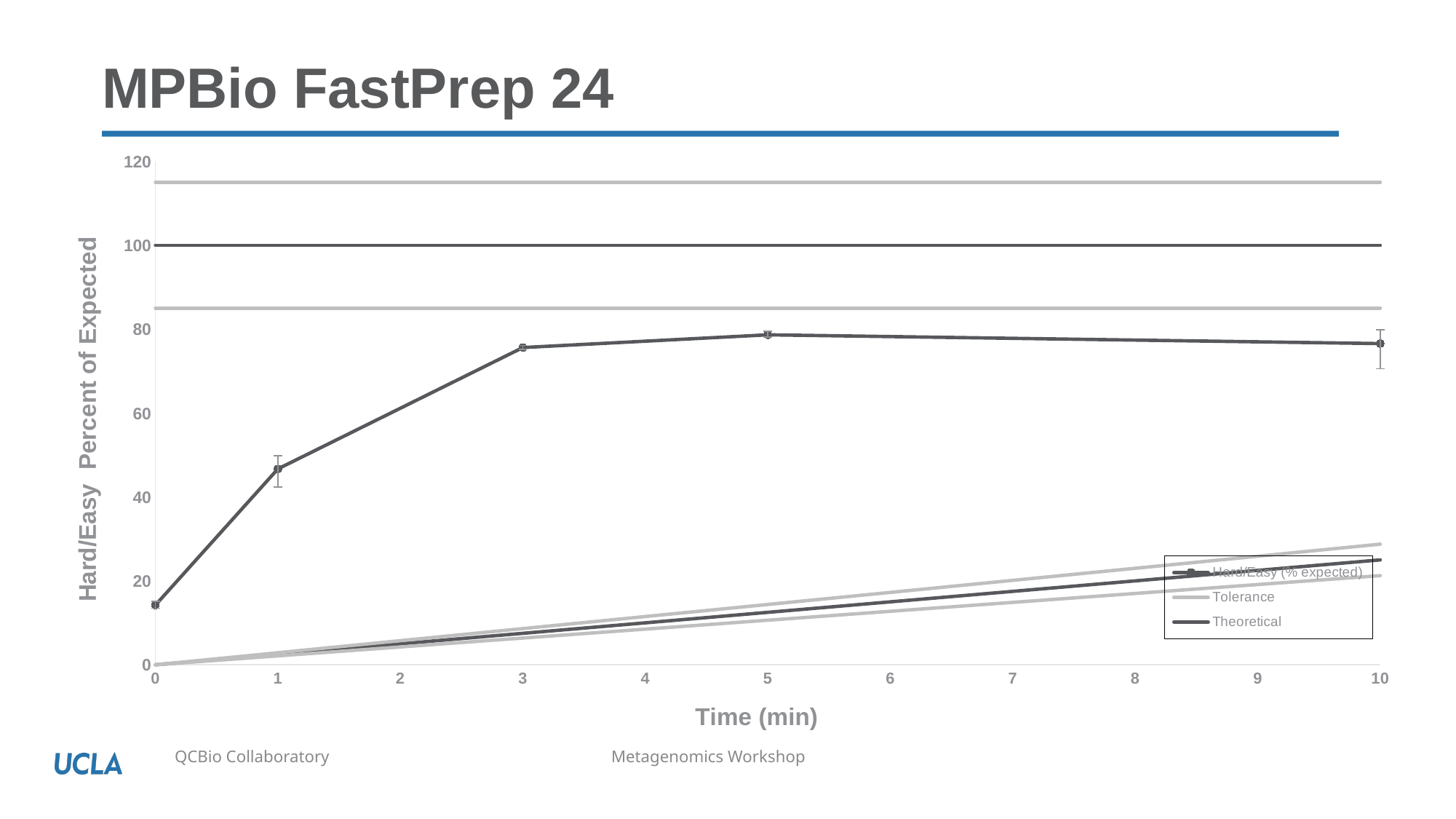
At which time point is the Hard/Easy (% expected) value lowest? 0 min Is the Hard/Easy (% expected) value at 1 min greater or less than 40? greater How many data points are plotted for the Hard/Easy (% expected) series? 5 Which is larger, the Hard/Easy (% expected) value at 1 min or at 3 min? 3 min What is the label of the x axis? Time (min) Is the Hard/Easy (% expected) value at 0 min greater or less than 20? less Is the Hard/Easy (% expected) value at 5 min greater or less than 60? greater What kind of chart is shown on the slide? line chart Does the Hard/Easy (% expected) series rise or fall between 0 min and 3 min? rise How many series does the legend list? 3